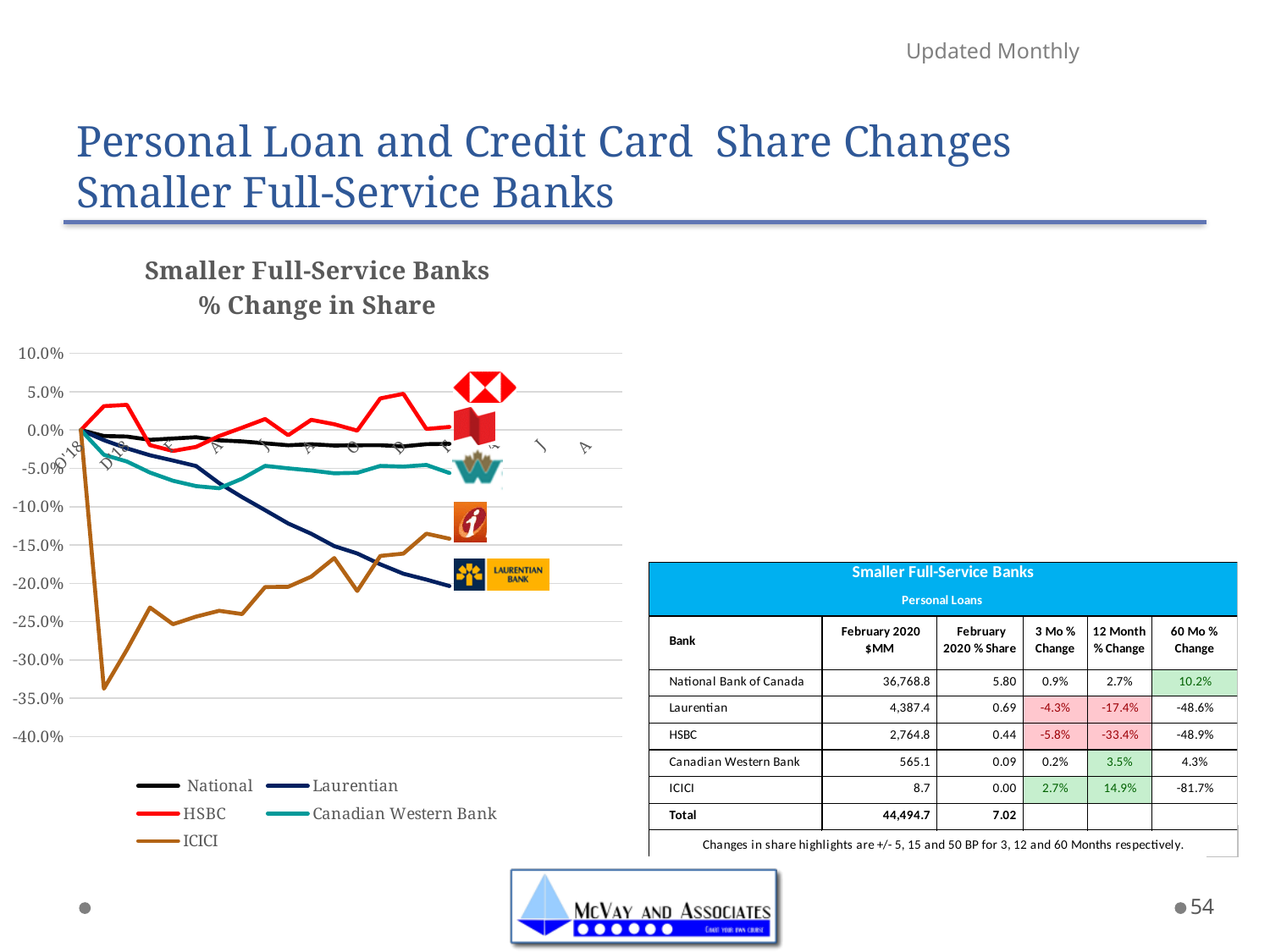
Which series in the chart reaches the lowest point? ICICI What is the title of the chart? Smaller Full-Service Banks % Change in Share Is the final value of the National line greater or less than -5.0%? greater At the right end of the chart, which is higher: the Laurentian line or the Canadian Western Bank line? Canadian Western Bank Is the highest value of the HSBC line greater or less than 0.0%? greater Is the lowest value of the ICICI line greater or less than -30.0%? less How many series does the chart legend list? 5 Which series is drawn in red in the chart? HSBC Does the Laurentian line rise or fall along the x axis? Fall What type of chart is shown on the slide? Line chart Which series in the chart reaches the highest point? HSBC